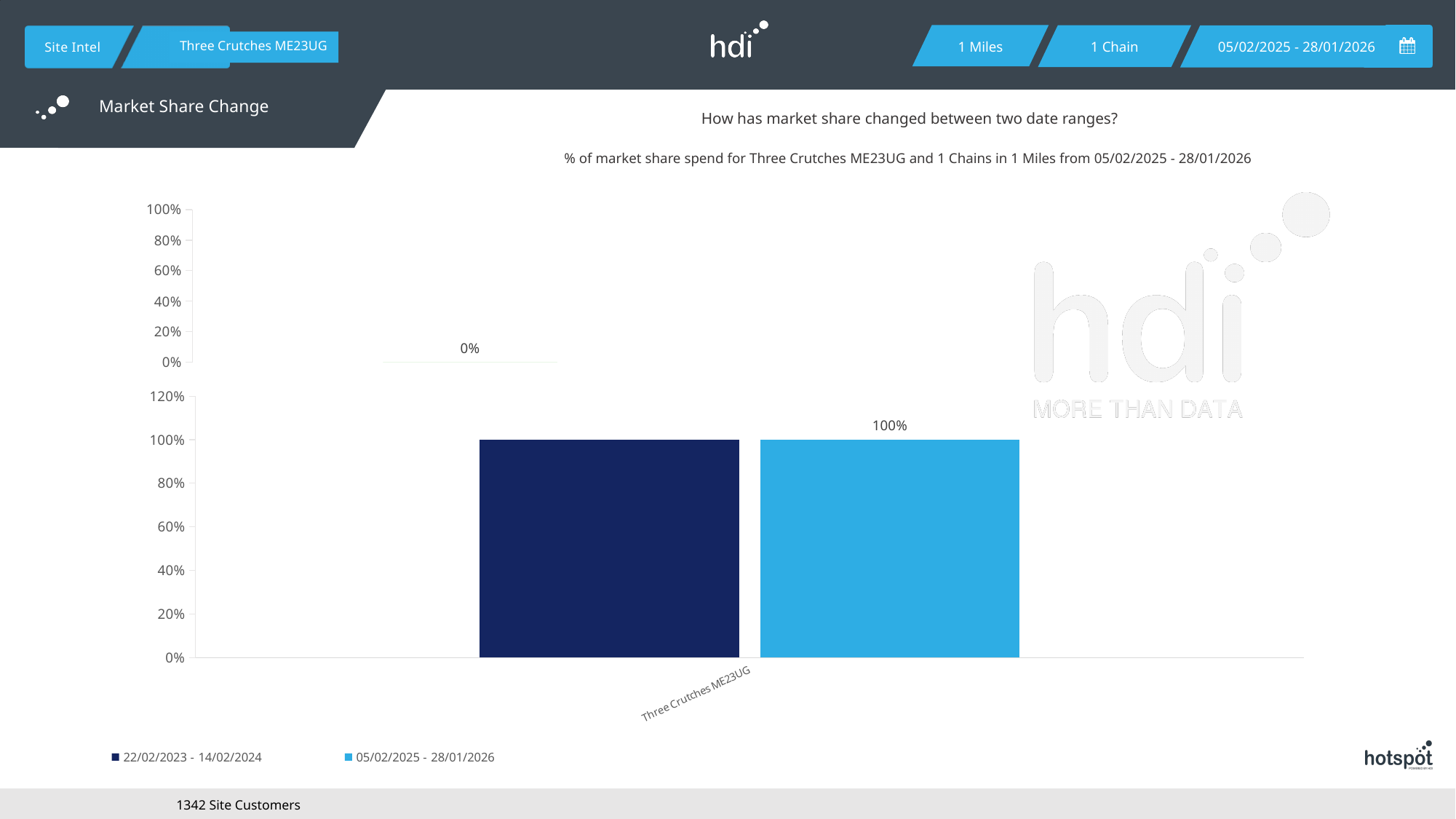
In the bottom chart, what is the difference between the 05/02/2025 - 28/01/2026 value and the 22/02/2023 - 14/02/2024 value for Three Crutches ME23UG? 0% In the bottom chart, what is the value for Three Crutches ME23UG in the 05/02/2025 - 28/01/2026 series? 100% In the bottom chart, how many categories are shown on the x axis? 1 In the bottom chart, what is the value for Three Crutches ME23UG in the 22/02/2023 - 14/02/2024 series? 100% What are the two legend entries of the bottom chart? 22/02/2023 - 14/02/2024 and 05/02/2025 - 28/01/2026 In the bottom chart, is the value for the 22/02/2023 - 14/02/2024 series greater or less than 60%? greater What kind of chart is the bottom chart on the slide? bar chart In the top chart, what value is printed above the bar? 0% In the bottom chart, how many series does the legend list? 2 What is the title shown in the top-left header of the slide? Market Share Change In the top chart, is the plotted value greater or less than 20%? less